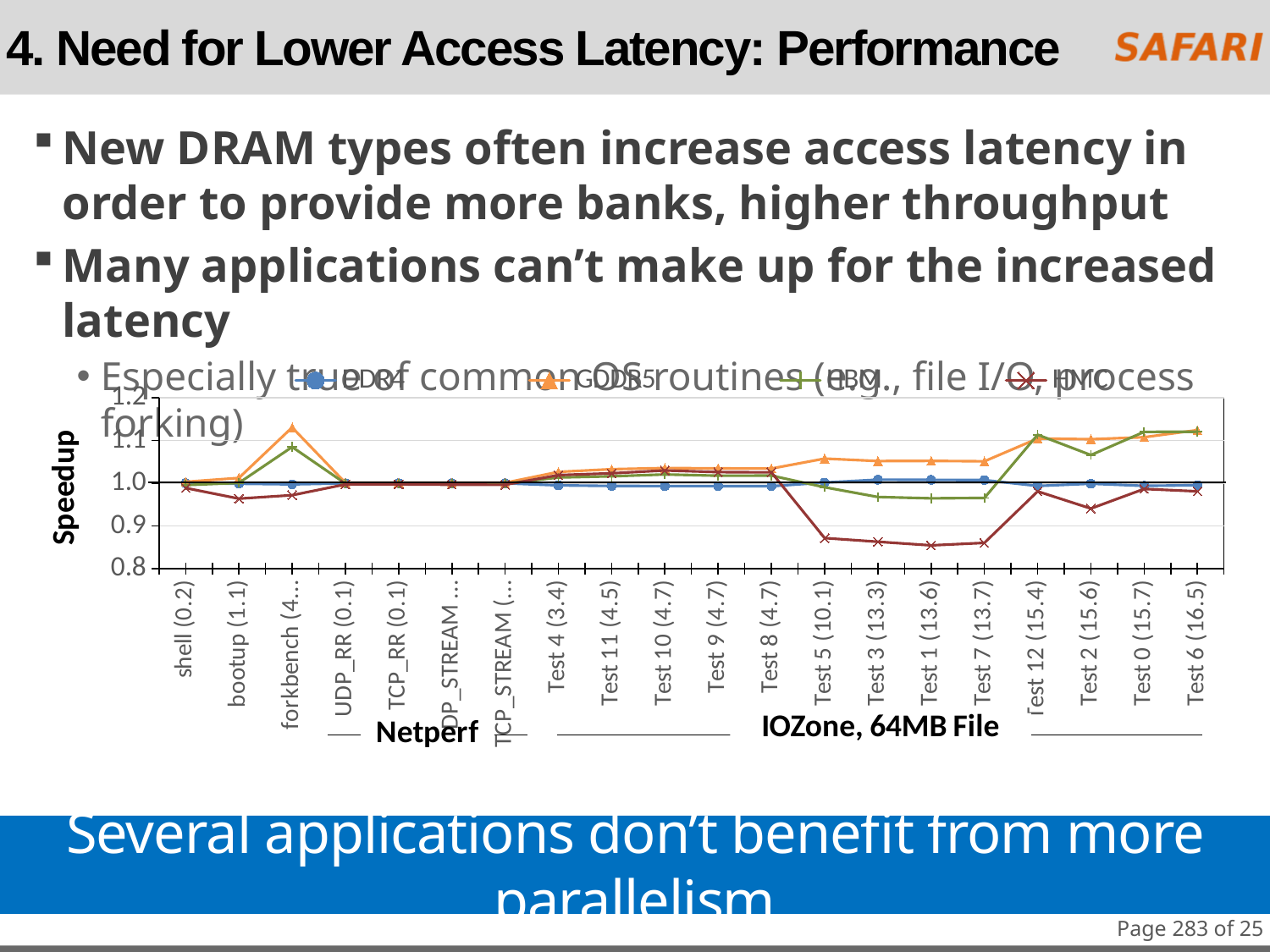
Is the GDDR5 value for forkbench greater or less than 1.1? greater Is the HBM value for Test 3 (13.3) greater or less than 1.0? less Is the GDDR5 value for Test 5 (10.1) greater or less than 1.0? greater Which series is highest at forkbench? GDDR5 What is the label of the y axis of the chart? Speedup How many series does the chart's legend list? 4 What kind of chart is shown on the slide? line chart How many categories are plotted along the x axis of the chart? 20